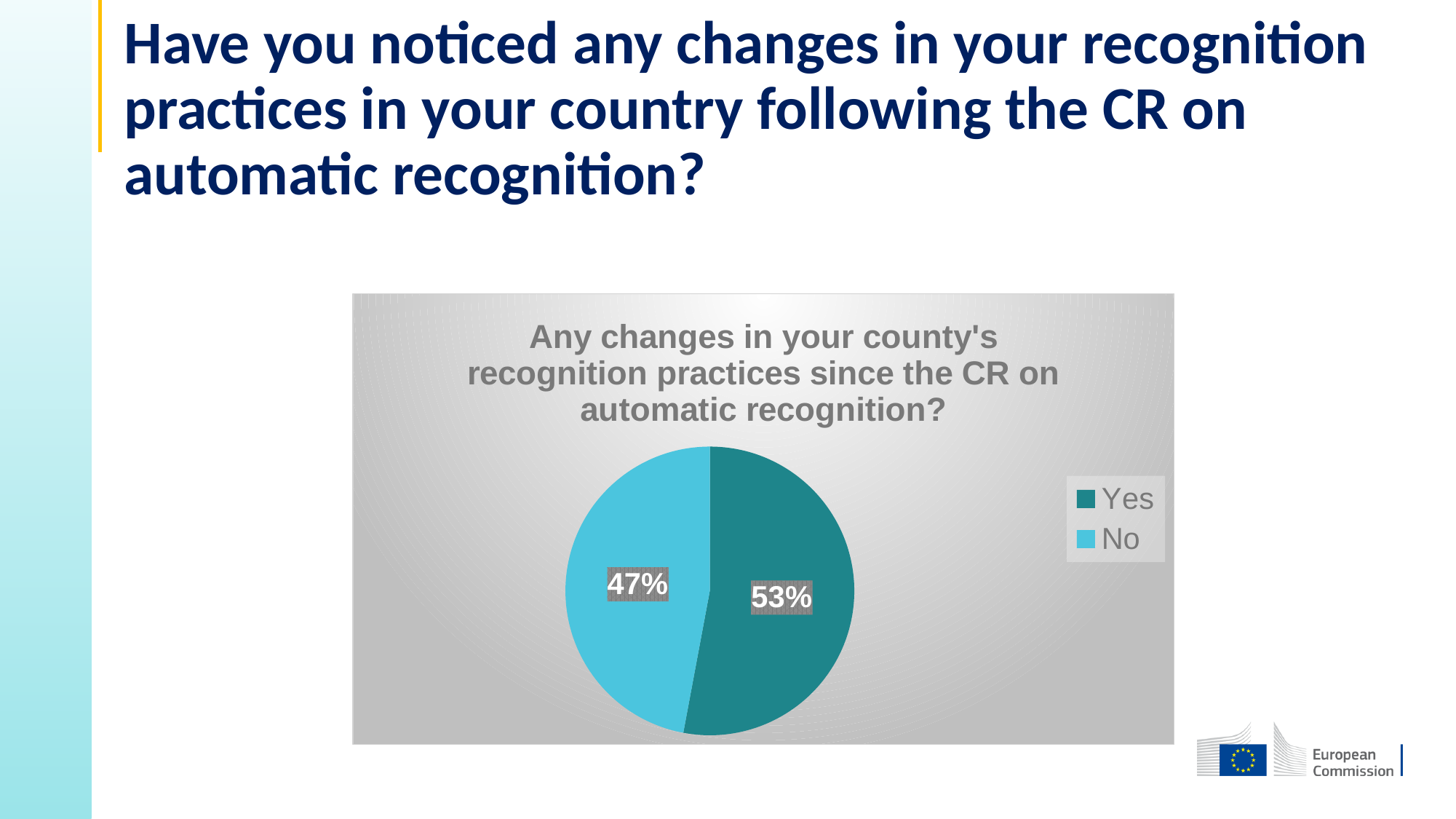
Is the share for Yes greater or less than 50%? greater What is the title of the chart? Any changes in your county's recognition practices since the CR on automatic recognition? What percentage of respondents answered No? 47% What is the difference in percentage points between the Yes and No shares? 6 Which response has the smaller share of the pie? No How many slices does the pie chart have? 2 Which response has the larger share of the pie? Yes Is the share for Yes larger or smaller than the share for No? larger What percentage of respondents answered Yes? 53% What kind of chart is shown on the slide? pie chart Which legend entry is shown in the lighter blue colour? No How many entries does the legend list? 2